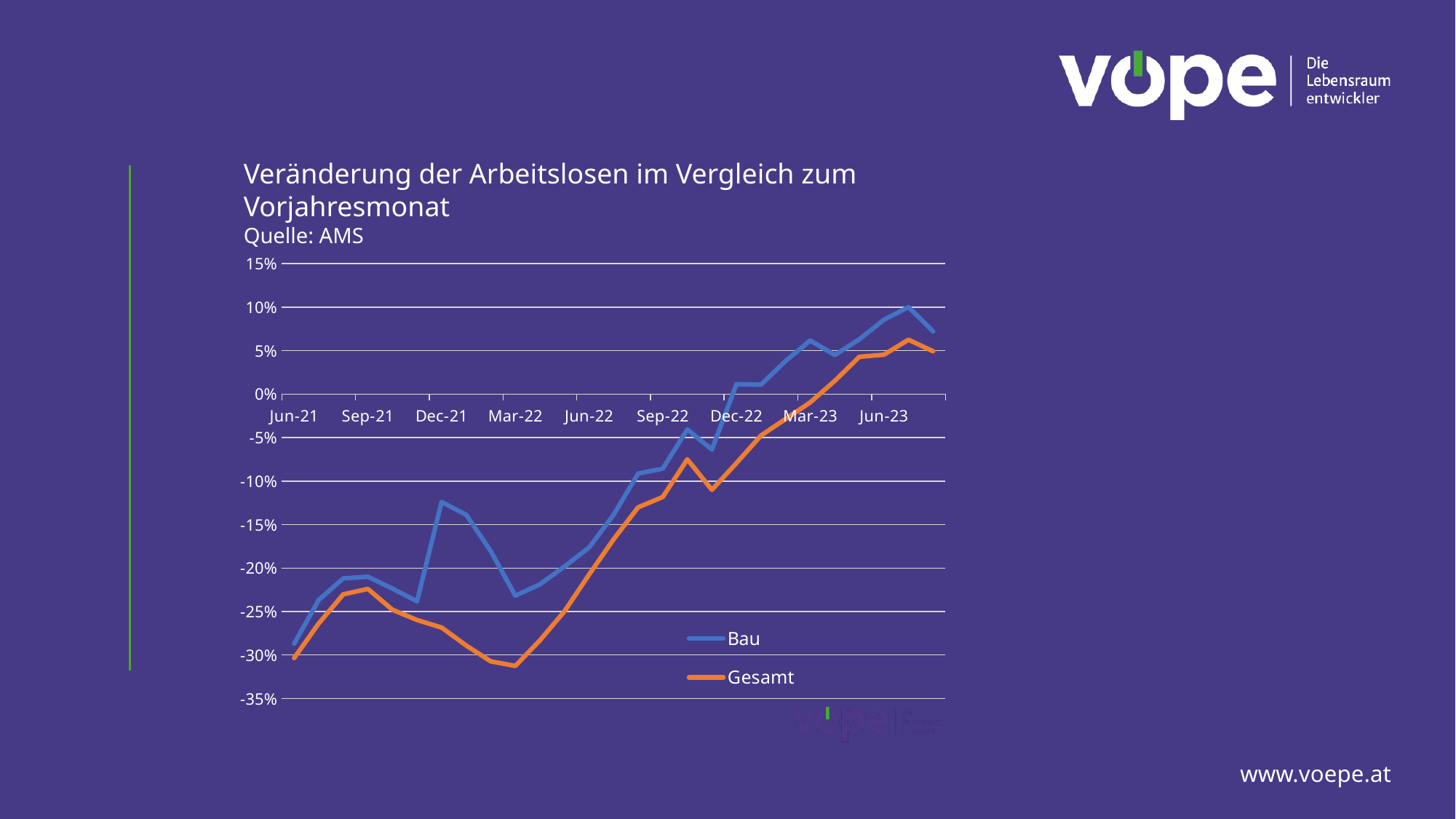
Do the values for Bau generally rise or fall from Jun-21 to Jun-23? rise At Mar-22, which series has the lower value, Bau or Gesamt? Gesamt Is the value for Bau at Jun-21 greater or less than -25%? less How many month labels are shown on the x axis? 9 Is the value for Gesamt at Mar-22 greater or less than -30%? less Is the value for Bau at Dec-21 greater or less than -15%? greater What kind of chart is shown on the slide? line chart What source is cited below the chart title? AMS How many series does the legend list? 2 What are the two series named in the legend? Bau and Gesamt At Dec-21, which series has the higher value, Bau or Gesamt? Bau